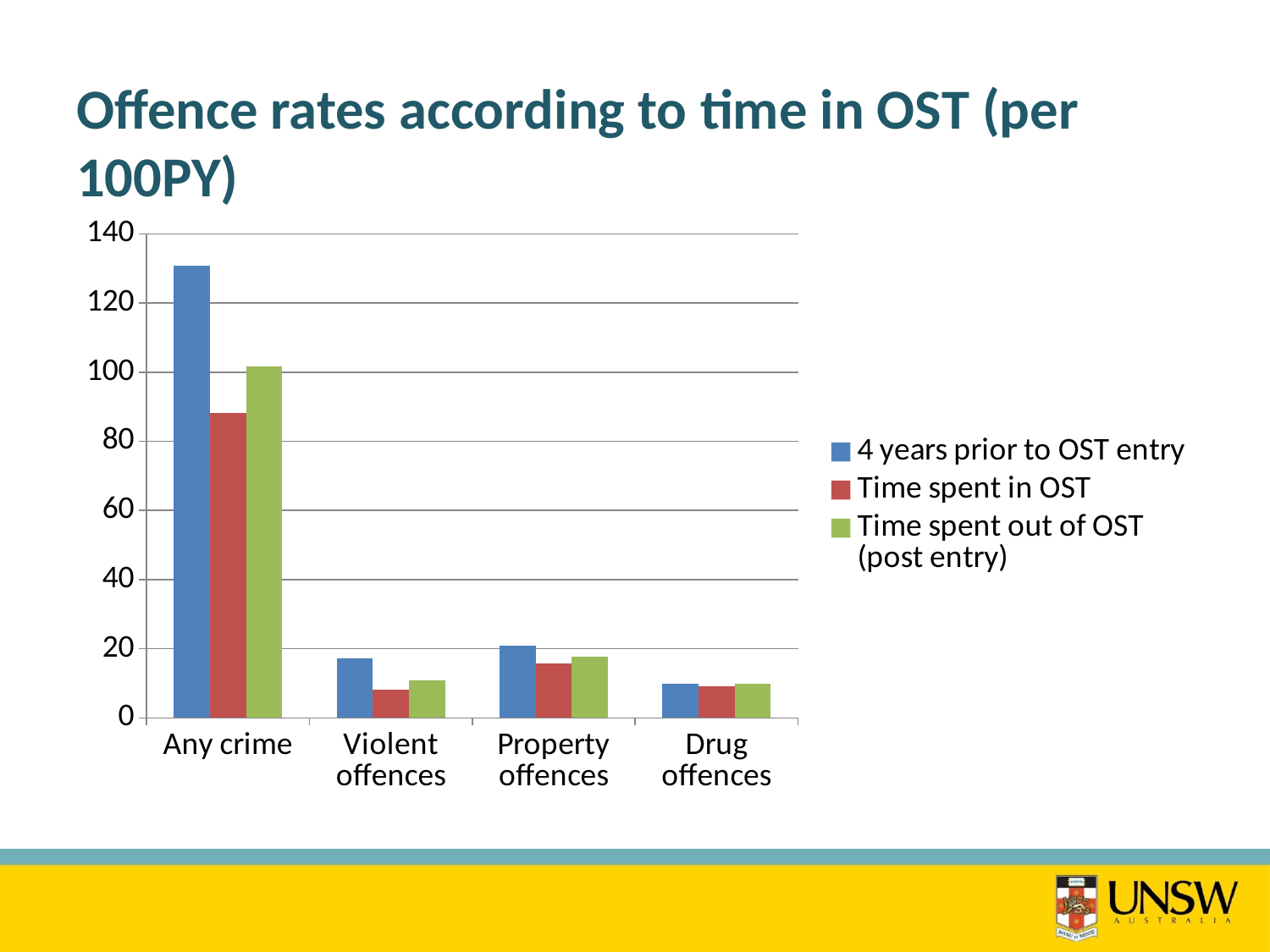
What kind of chart is shown on the slide? bar chart Is the value for 'Any crime' in the 'Time spent in OST' series greater or less than 100? less For 'Any crime', which is larger: 'Time spent in OST' or 'Time spent out of OST (post entry)'? Time spent out of OST (post entry) For 'Violent offences', which is larger: '4 years prior to OST entry' or 'Time spent in OST'? 4 years prior to OST entry How many series does the legend list? 3 Which category has the highest value for '4 years prior to OST entry'? Any crime How many categories are shown on the x axis? 4 Is the value for 'Any crime' in the '4 years prior to OST entry' series greater or less than 120? greater Which category has the lowest value for 'Time spent in OST'? Violent offences What is the title of the chart? Offence rates according to time in OST (per 100PY)